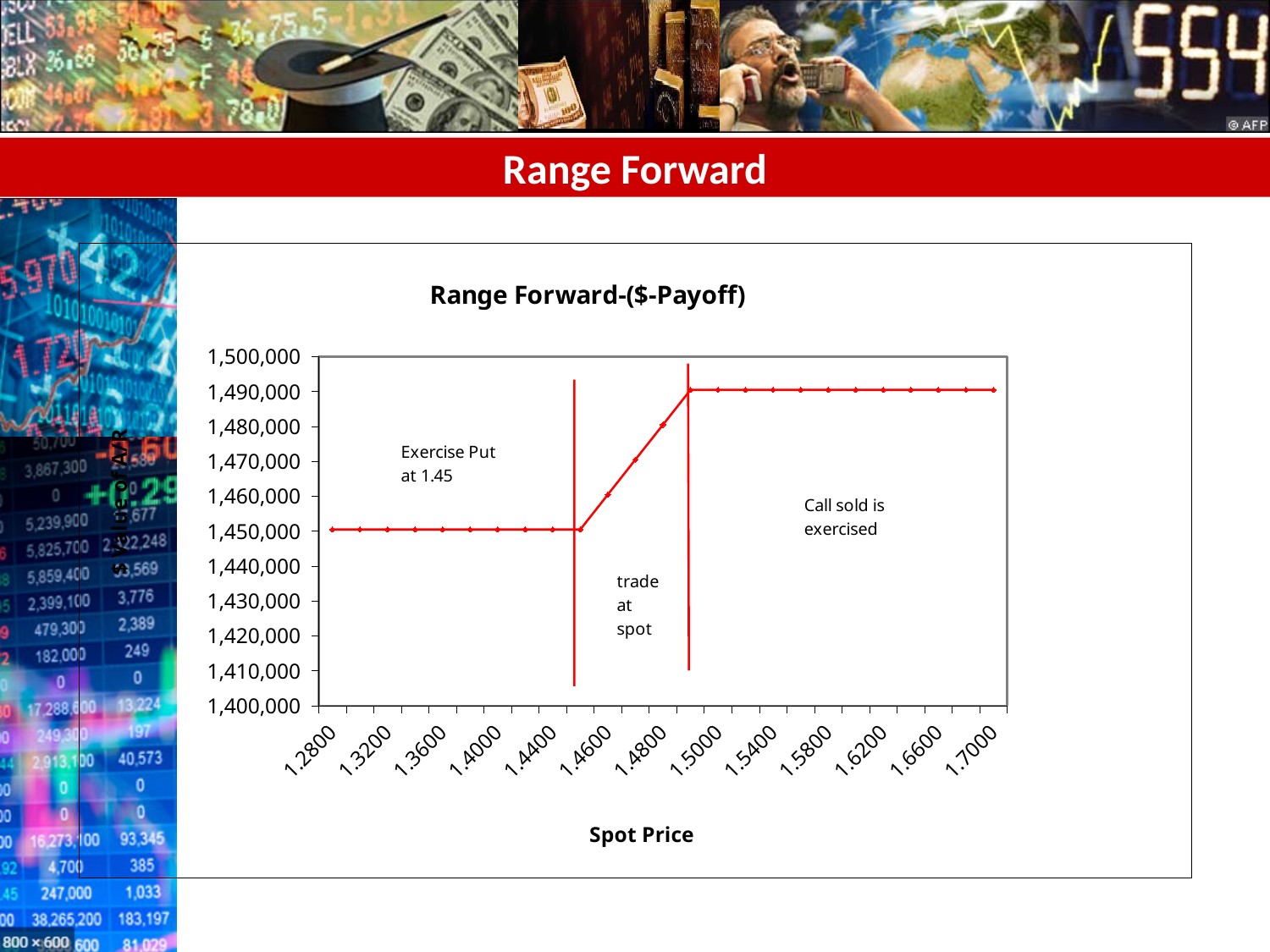
What is the title of the chart? Range Forward-($-Payoff) Is the $-Payoff at a spot price of 1.4800 greater or less than 1,470,000? greater What kind of chart is shown on the slide? line chart Do the plotted values rise or fall as the spot price increases along the x axis? rise What is the label of the x axis? Spot Price How many spot price labels are shown on the x axis? 13 Is the $-Payoff at a spot price of 1.4000 greater or less than 1,460,000? less Which spot price has the larger $-Payoff, 1.3200 or 1.6200? 1.6200